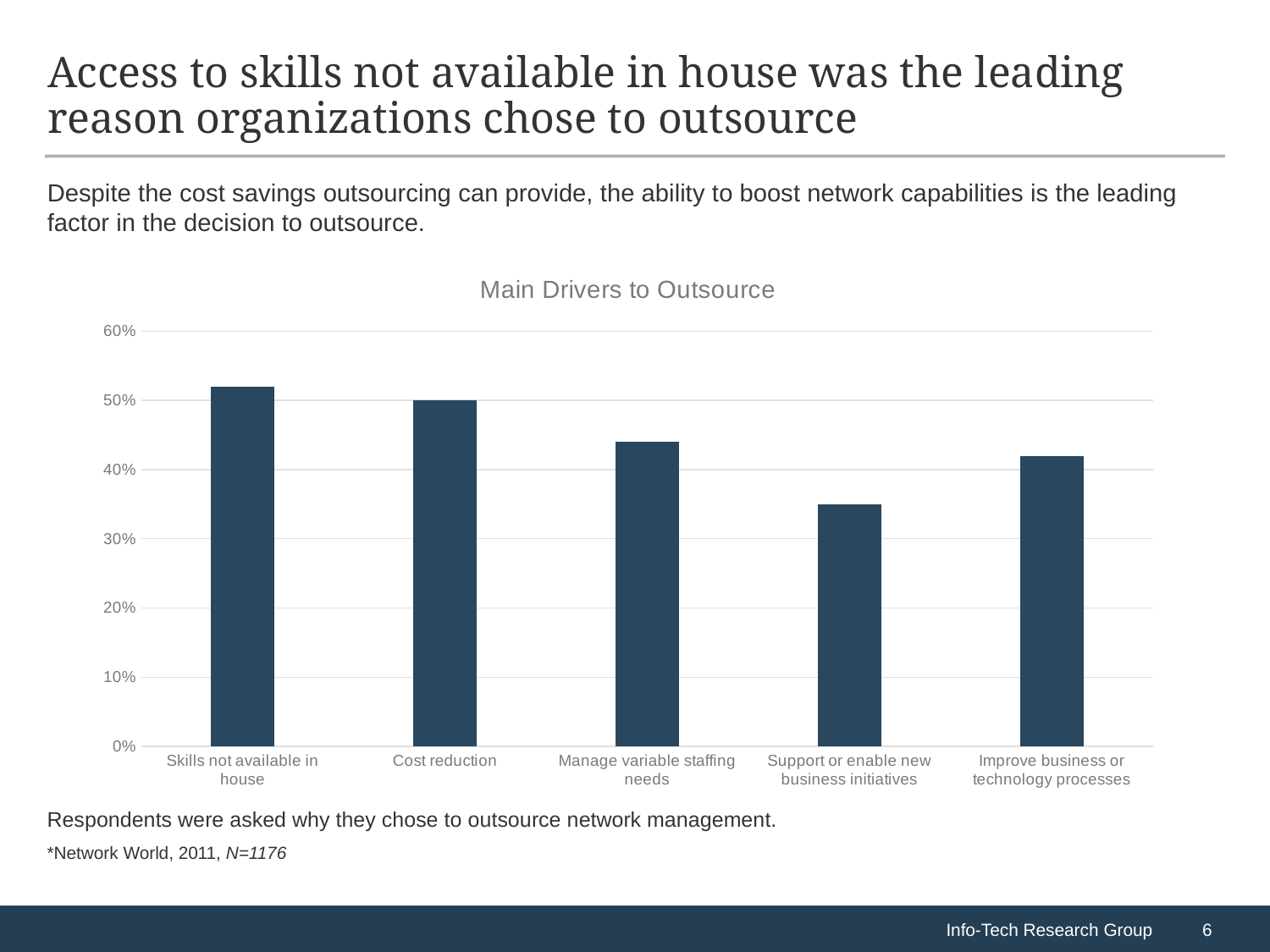
What is the title of the chart? Main Drivers to Outsource How many categories are plotted in the chart? 5 Is the value for Improve business or technology processes greater or less than 40%? greater Is the value for Support or enable new business initiatives greater or less than 40%? less What kind of chart is shown on the slide? bar chart Is the value for Manage variable staffing needs greater or less than 50%? less Which category has the highest value? Skills not available in house What is the highest value shown on the vertical axis? 60% Which category has the lowest value? Support or enable new business initiatives Which is larger, the value for Support or enable new business initiatives or the value for Skills not available in house? Skills not available in house Which is larger, the value for Cost reduction or the value for Manage variable staffing needs? Cost reduction